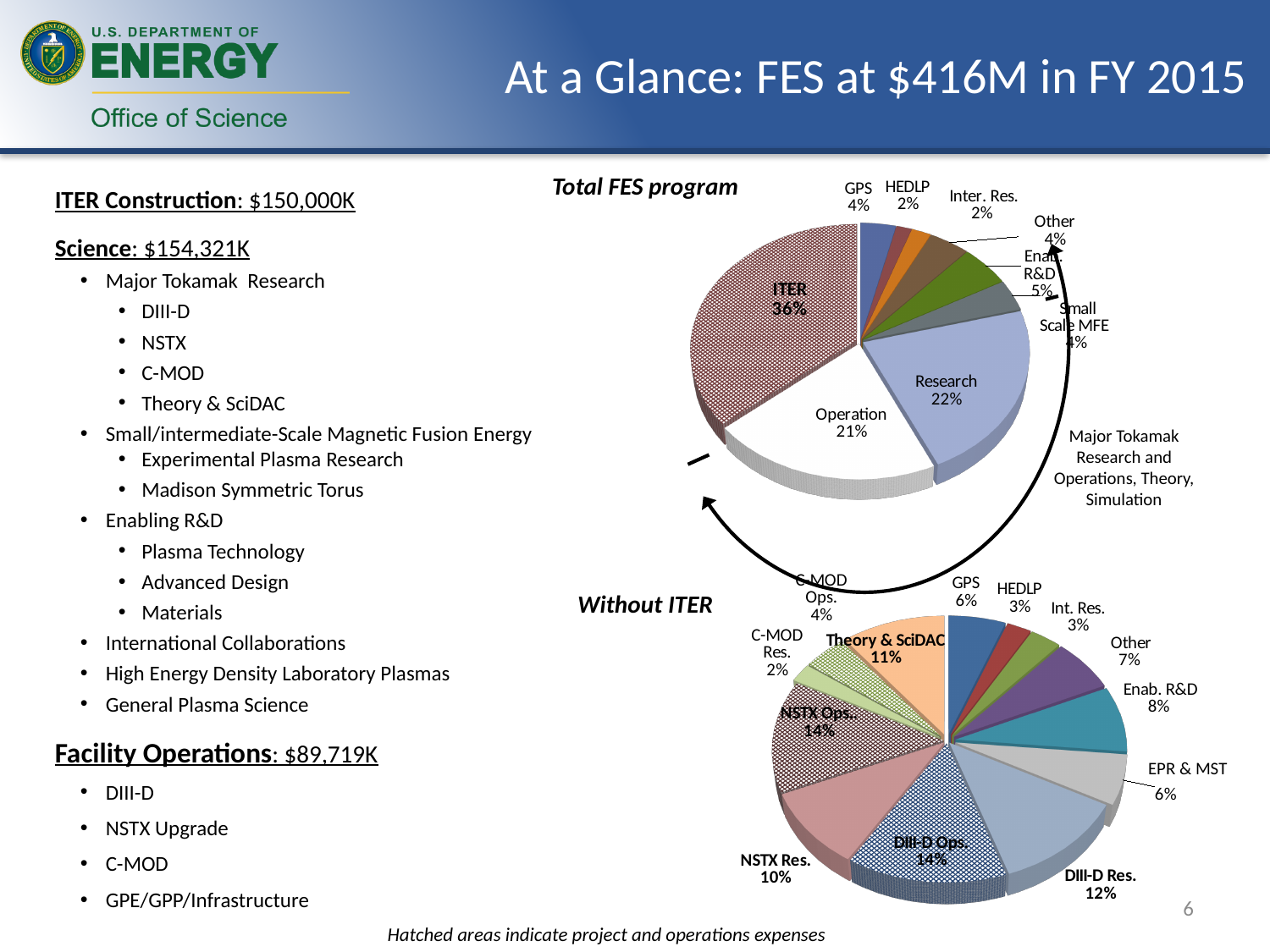
What kind of chart is the Total FES program chart? Pie chart In the Without ITER pie chart, what share does Theory & SciDAC represent? 11% In the Without ITER pie chart, how many slices are there? 13 In the Without ITER pie chart, which slice is the smallest? C-MOD Res. In the Total FES program pie chart, what share does Research represent? 22% In the Without ITER pie chart, which is larger, DIII-D Res. or NSTX Res.? DIII-D Res. In the Total FES program pie chart, which slice is the largest? ITER In the Total FES program pie chart, what is the difference between the Research and Operation shares? 1% In the Without ITER pie chart, what is the difference between the DIII-D Ops. and C-MOD Ops. shares? 10% In the Total FES program pie chart, what share does ITER represent? 36% In the Total FES program pie chart, how many slices are there? 9 In the Without ITER pie chart, what share does Enab. R&D represent? 8%